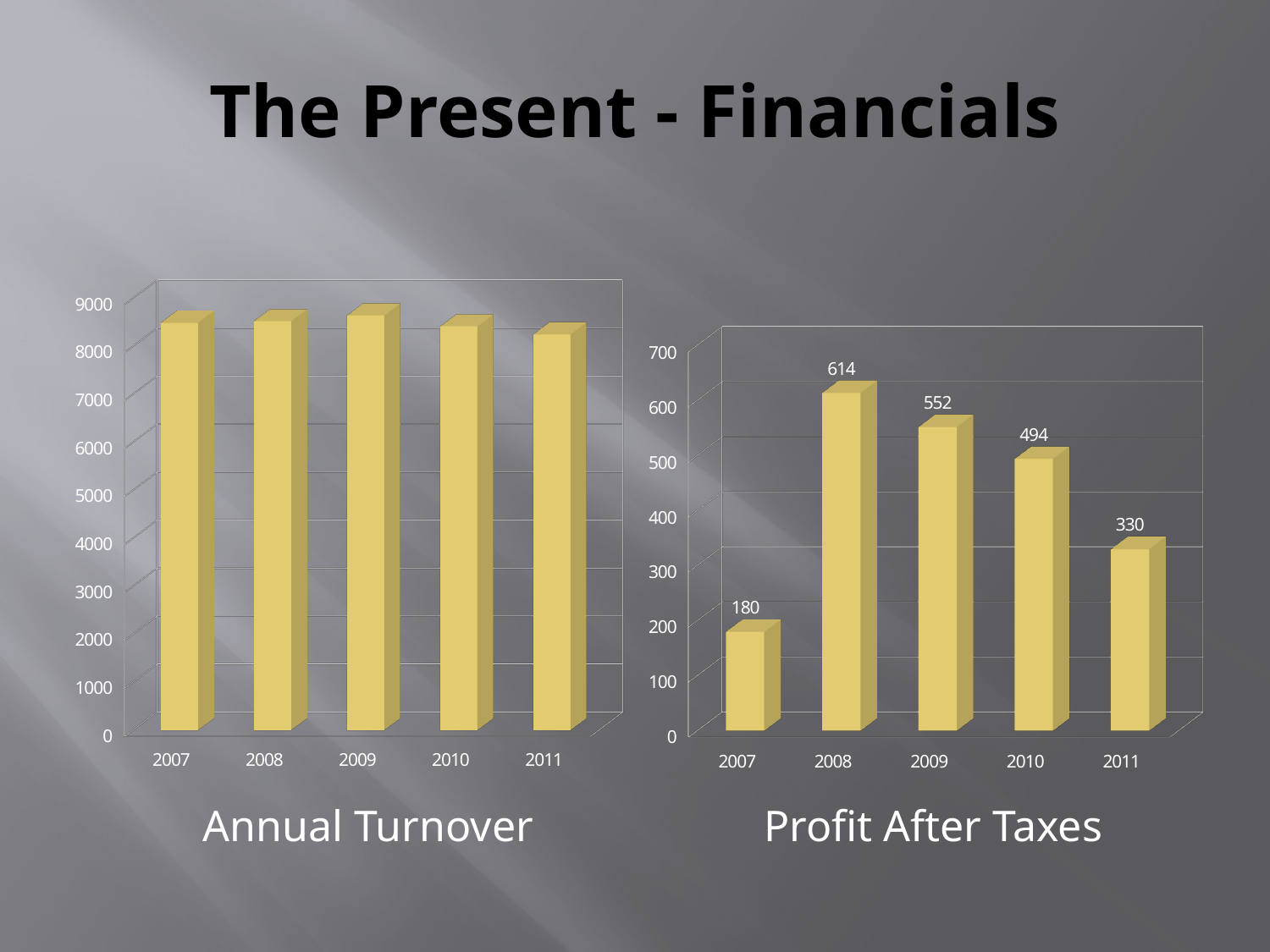
In the Profit After Taxes chart, which year has the highest value? 2008 In the Profit After Taxes chart, which year has the lowest value? 2007 How many years are shown on the x axis of the Annual Turnover chart? 5 In the Profit After Taxes chart, what is the value for 2008? 614 In the Annual Turnover chart, is the value for 2011 greater or less than 9000? less In the Profit After Taxes chart, do the values rise or fall from 2008 to 2011? fall In the Profit After Taxes chart, what is the value for 2011? 330 In the Profit After Taxes chart, what is the value for 2007? 180 In the Annual Turnover chart, is the value for 2009 greater or less than 8000? greater In the Profit After Taxes chart, what is the difference between the values for 2008 and 2007? 434 In the Profit After Taxes chart, which is larger, the value for 2009 or the value for 2011? 2009 In the Profit After Taxes chart, what is the difference between the values for 2009 and 2010? 58